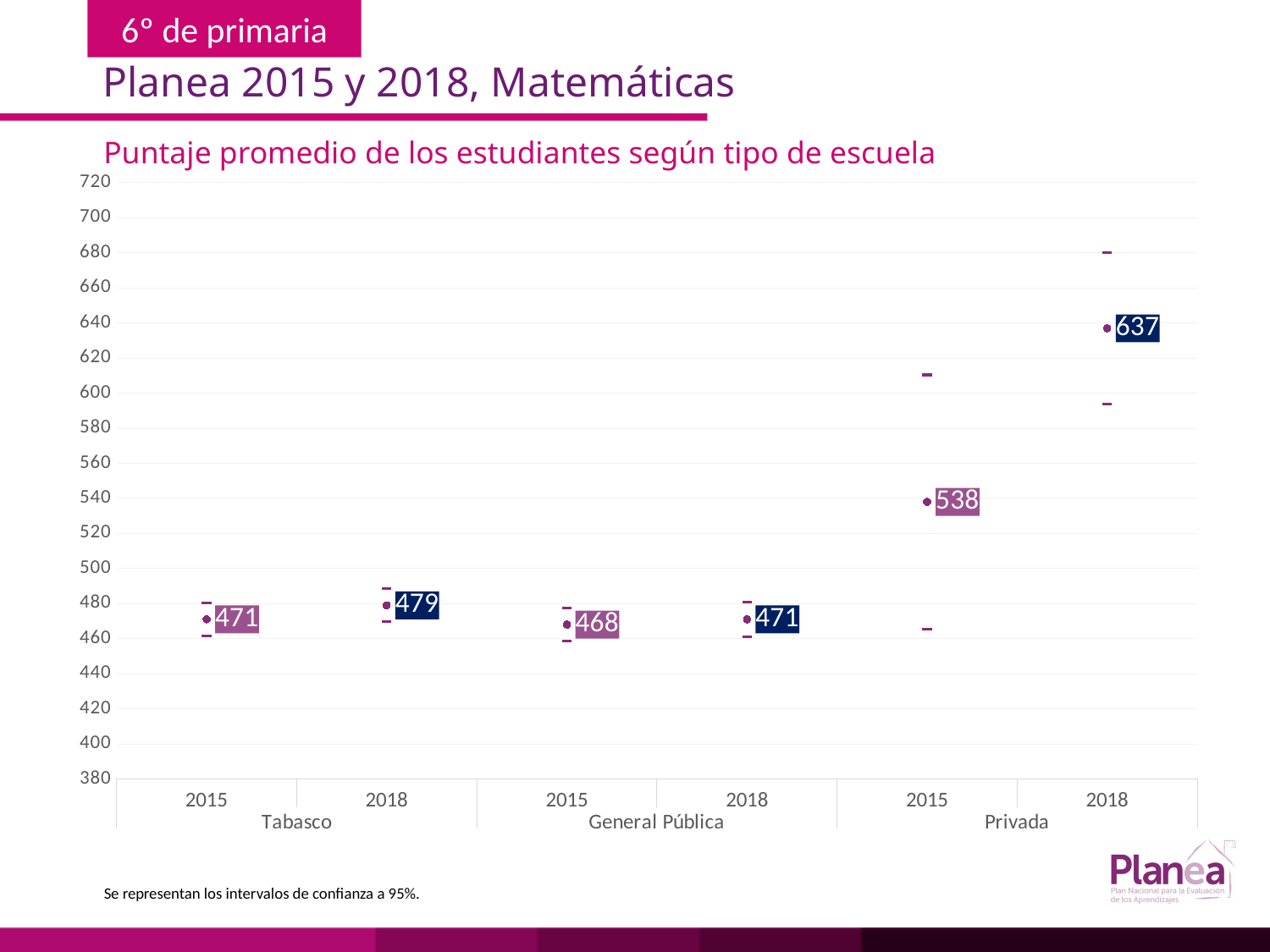
Which is larger, the Tabasco 2018 score or the General Pública 2018 score? Tabasco 2018 Is the Privada 2015 score greater or less than 500? greater Which group and year has the lowest average score? General Pública 2015 What is the average score for Tabasco in 2015? 471 Which group and year has the highest average score? Privada 2018 What is the average score for Tabasco in 2018? 479 What is the average score for General Pública schools in 2015? 468 How many data points are plotted on the chart? 6 What is the title of the chart? Puntaje promedio de los estudiantes según tipo de escuela What is the difference between the Tabasco 2018 score and the General Pública 2018 score? 8 What is the average score for Privada schools in 2018? 637 By how many points did the Privada average score increase from 2015 to 2018? 99